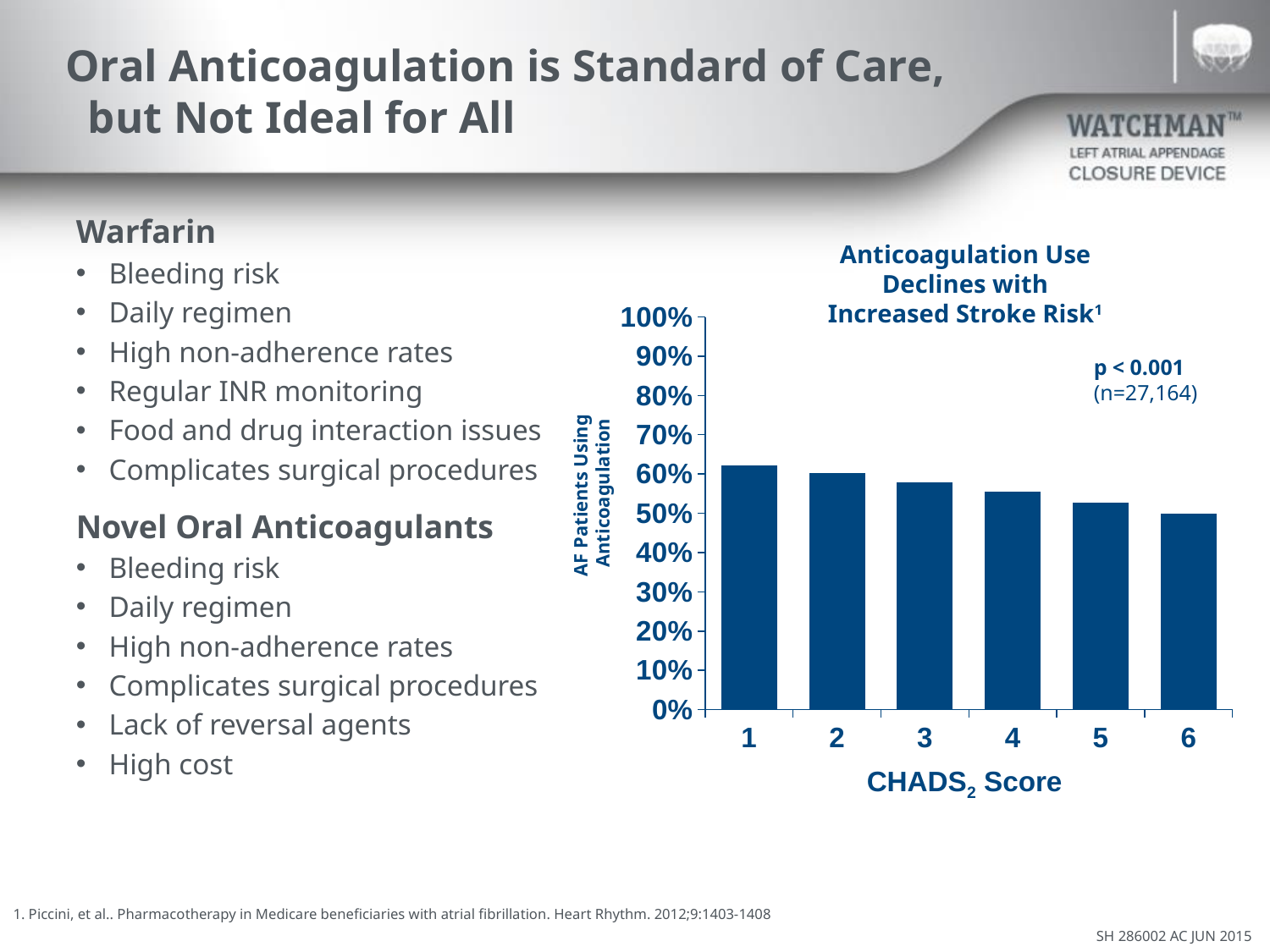
Is the value for CHADS2 score 4 greater or less than 50%? greater Is the value for CHADS2 score 1 greater or less than 70%? less What p-value is shown on the chart? p < 0.001 Which CHADS2 score has the lowest percentage of AF patients using anticoagulation? 6 Do the values rise or fall as the CHADS2 score increases from 1 to 6? fall How many CHADS2 score categories are plotted in the chart? 6 Is the value for CHADS2 score 6 greater or less than 60%? less What is the title of the chart? Anticoagulation Use Declines with Increased Stroke Risk What kind of chart is shown on the slide? bar chart Which CHADS2 score has the highest percentage of AF patients using anticoagulation? 1 Which has a larger value, CHADS2 score 1 or CHADS2 score 6? CHADS2 score 1